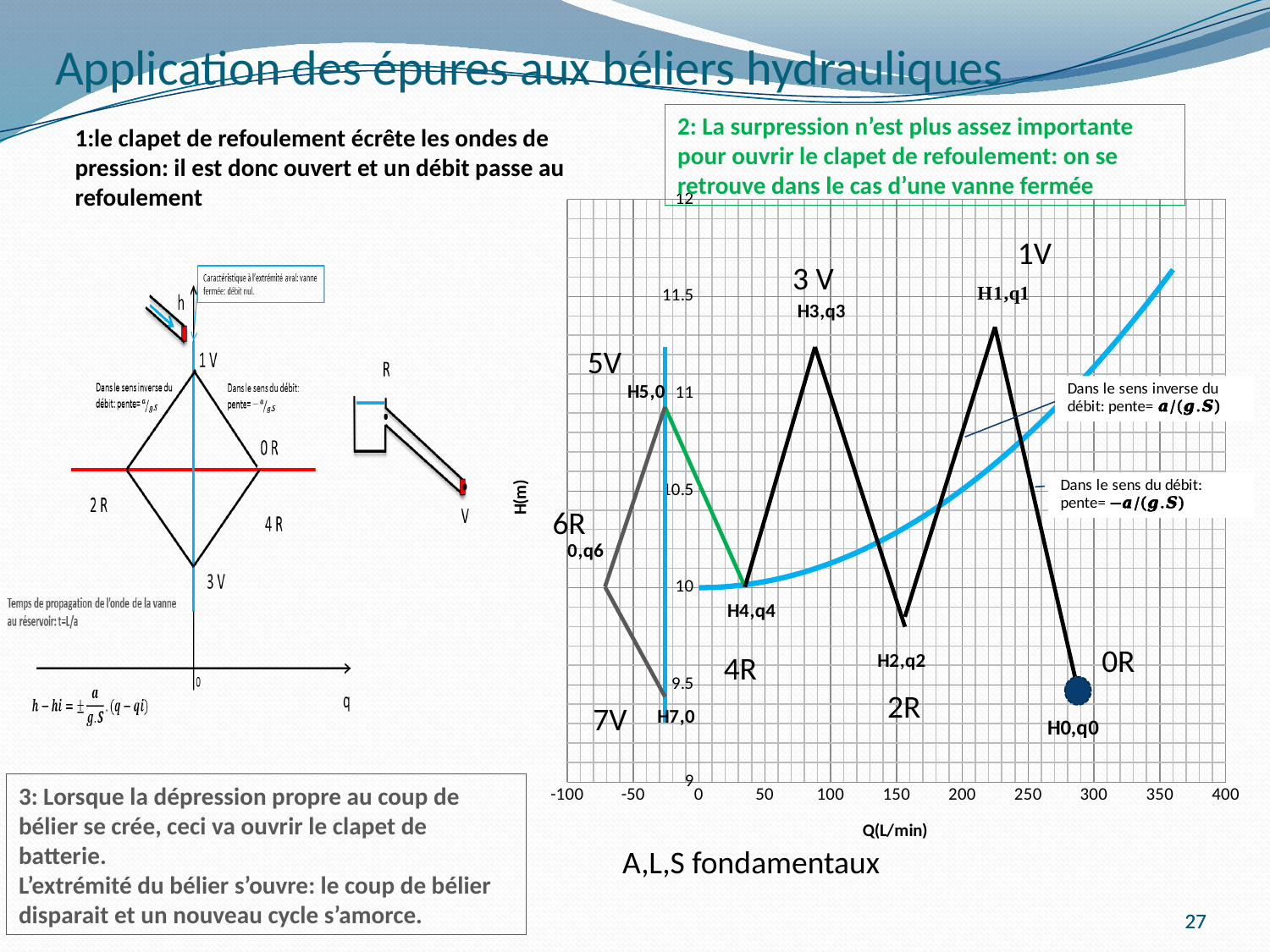
What is the title of the horizontal axis of the chart? Q(L/min) Is the Q value at the point labelled 0,q6 greater or less than -50? less Is the H value at the point labelled H0,q0 greater or less than 10? less Is the H value at the point labelled H1,q1 greater or less than 11? greater What kind of chart is shown on the right of the slide? line chart Which point has the higher H value, H1,q1 or H0,q0? H1,q1 Which point has the higher H value, H3,q3 or H2,q2? H3,q3 What is the title of the vertical axis of the chart? H(m)